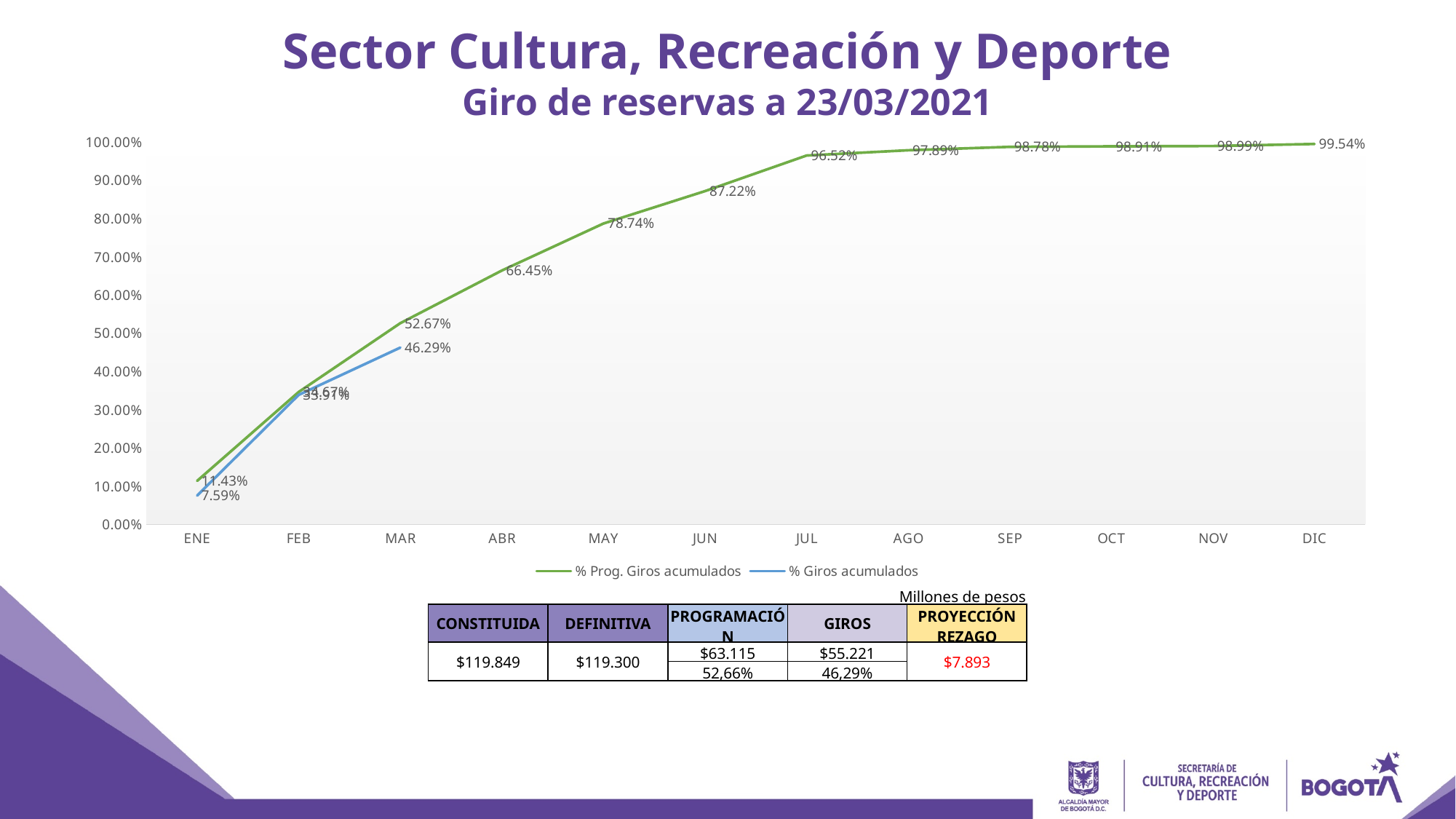
In which month is % Prog. Giros acumulados highest? DIC What is the value of % Prog. Giros acumulados for JUN? 87.22% What is the difference between % Prog. Giros acumulados and % Giros acumulados in MAR? 6.38% How many months are shown on the x axis of the chart? 12 What kind of chart is shown on the slide? line chart What is the value of % Prog. Giros acumulados for DIC? 99.54% What is the value of % Giros acumulados for MAR? 46.29% How many series does the chart legend list? 2 What is the value of % Prog. Giros acumulados for ENE? 11.43% What is the value of % Giros acumulados for ENE? 7.59% Which series is drawn in green in the chart? % Prog. Giros acumulados Does % Prog. Giros acumulados rise or fall from ENE to DIC? rise